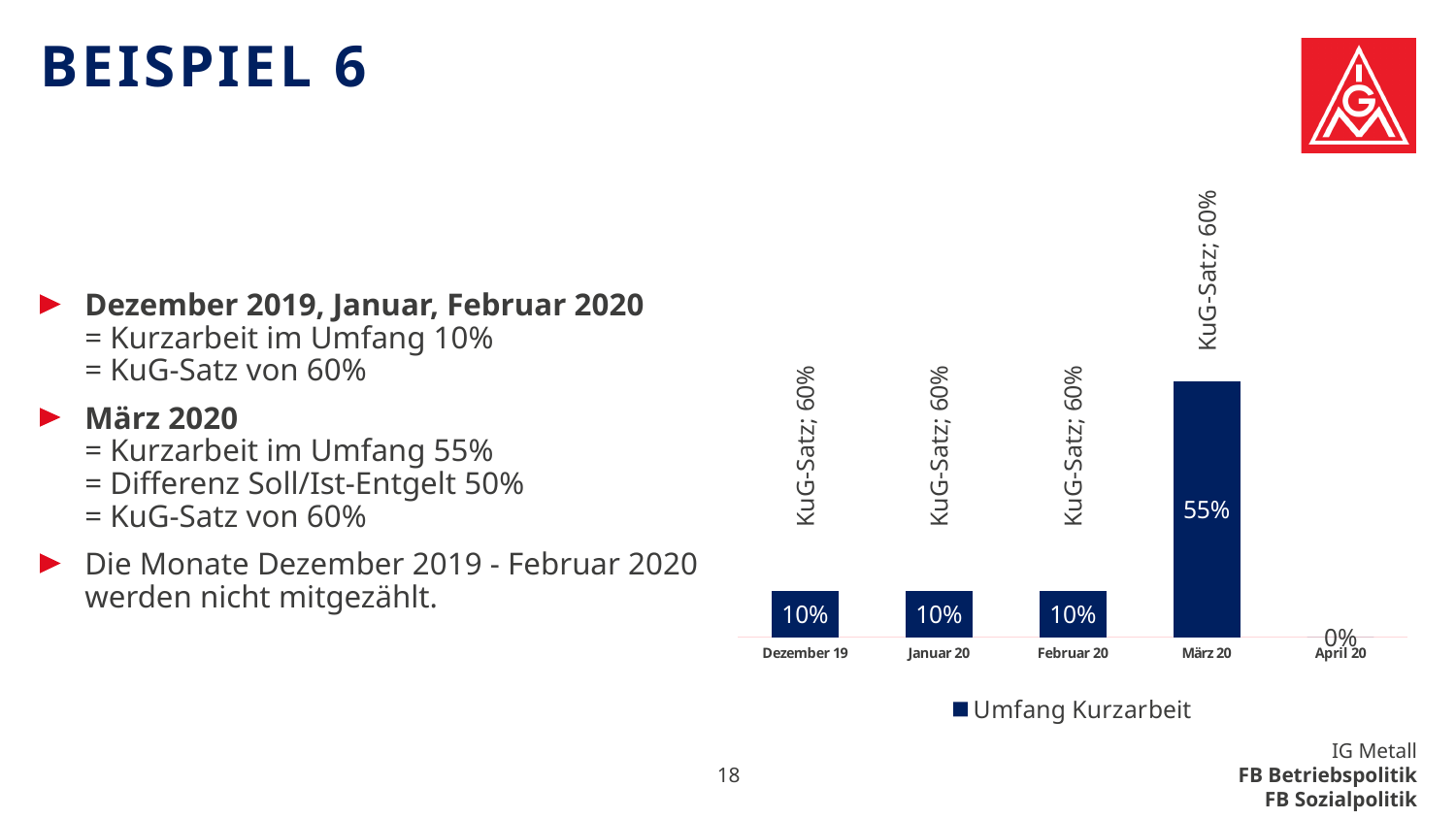
Which category has the lowest value in the chart? April 20 What is the value for März 20 in the chart? 55% What KuG-Satz is labelled above the bar for März 20? KuG-Satz; 60% What is the name of the series shown in the chart legend? Umfang Kurzarbeit What is the value for April 20 in the chart? 0% What is the difference between the values for März 20 and Februar 20? 45% How many categories are shown on the x axis of the chart? 5 Which is larger, the value for Januar 20 or the value for März 20? März 20 What kind of chart is shown on the slide? bar chart How many series does the chart legend list? 1 Which category has the highest value in the chart? März 20 What is the value for Dezember 19 in the chart? 10%